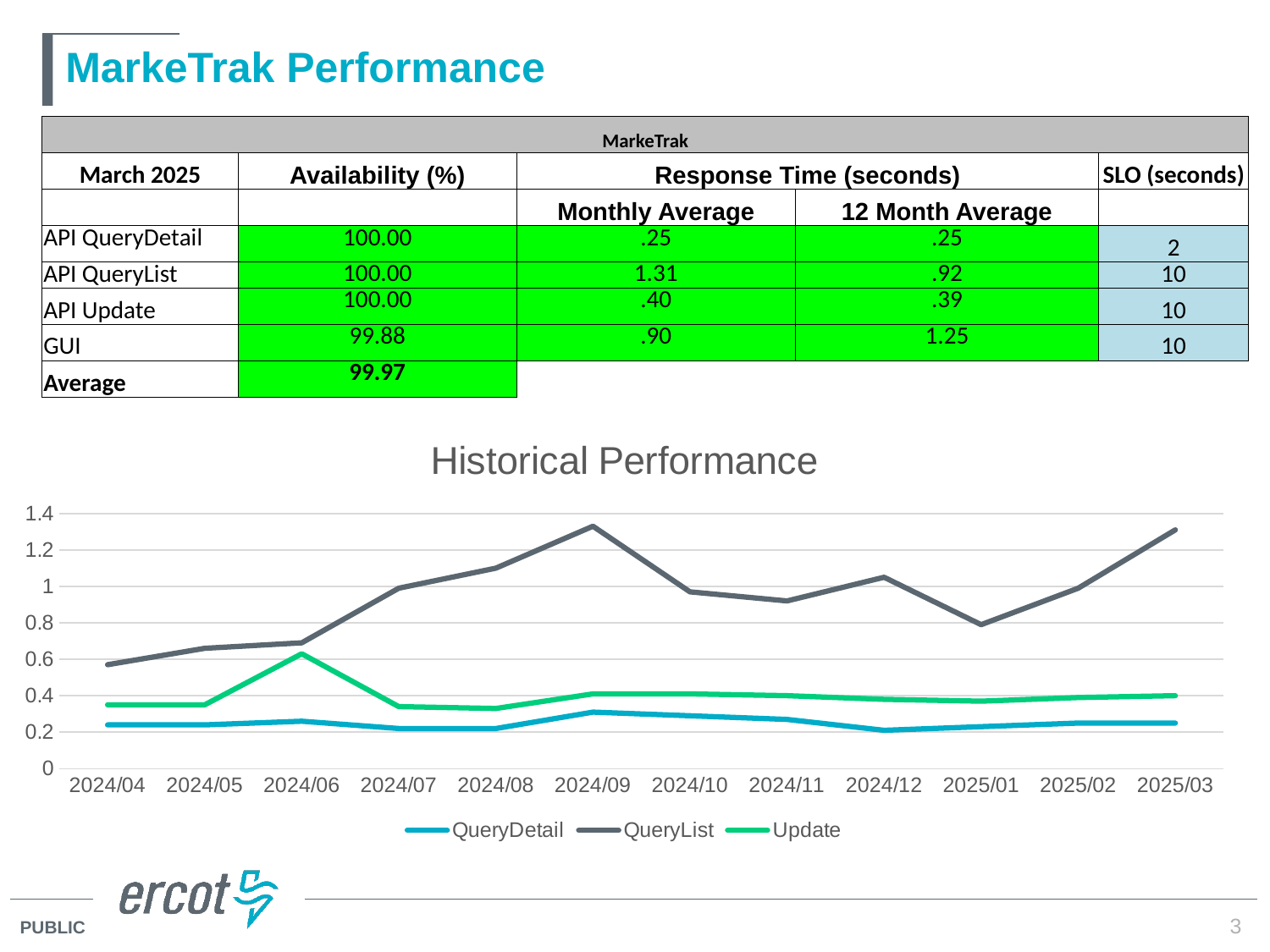
In the Historical Performance chart, is the QueryDetail value for 2024/12 greater or less than 0.4? less What kind of chart is the Historical Performance chart? line chart In the Historical Performance chart, which series has the lowest values across the whole period? QueryDetail How many months are plotted along the x axis of the Historical Performance chart? 12 How many series does the legend of the Historical Performance chart list? 3 In the Historical Performance chart, does the QueryList series rise or fall from 2025/01 to 2025/03? rise In the Historical Performance chart, in which month is the QueryList series at its lowest? 2024/04 In the Historical Performance chart, which is larger at 2025/03: QueryList or Update? QueryList In the Historical Performance chart, which series has the highest values across the whole period? QueryList In the Historical Performance chart, is the QueryList value for 2024/09 greater or less than 1.2? greater In the Historical Performance chart, in which month does the Update series reach its peak? 2024/06